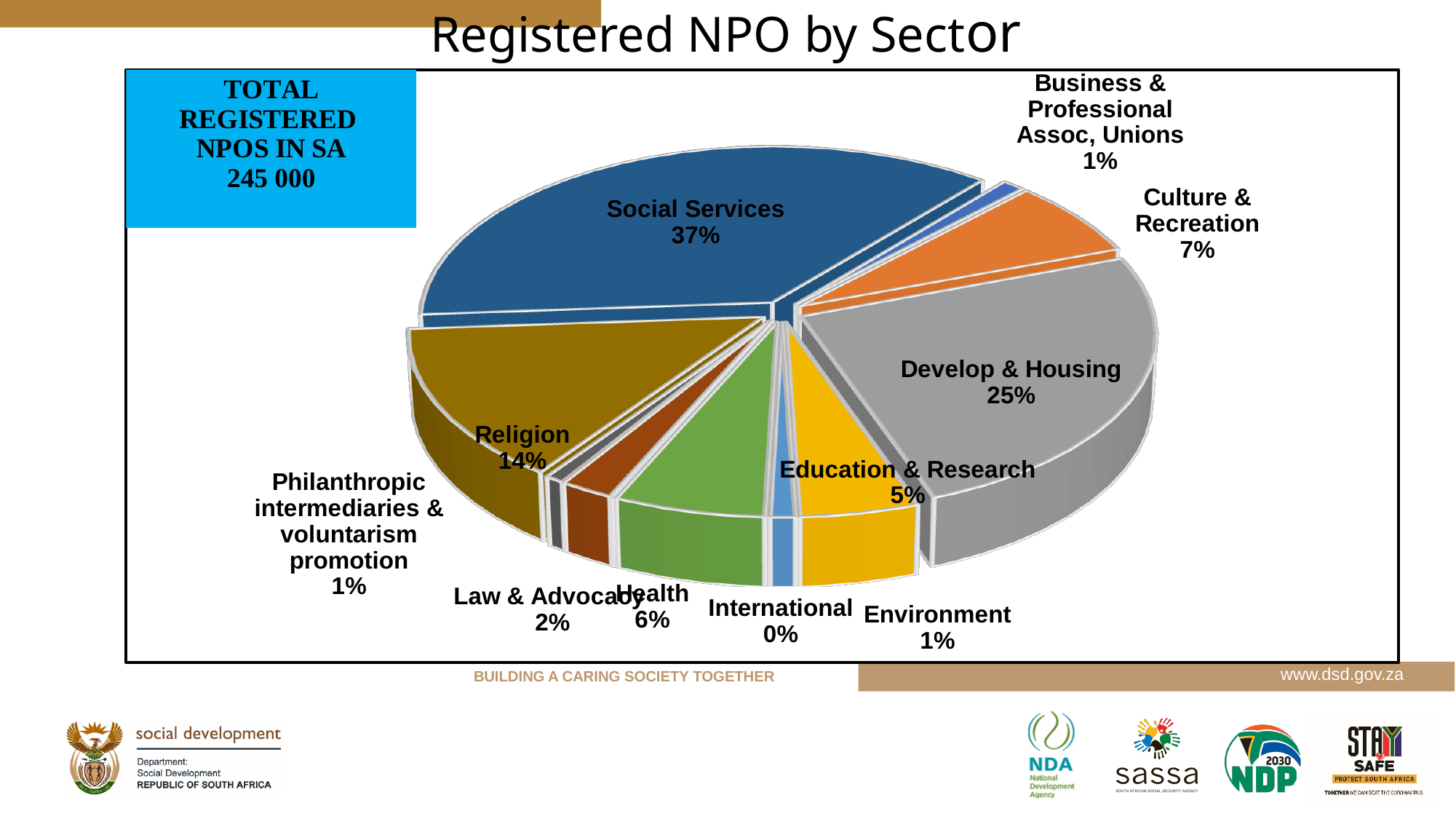
How many sectors are shown in the pie chart? 11 What is the total number of registered NPOs in SA stated on the slide? 245 000 What share of registered NPOs is in the Social Services sector? 37% Which sector has the largest share of registered NPOs? Social Services What percentage is shown for the International sector? 0% What kind of chart is shown on the slide? Pie chart What percentage of registered NPOs is in Develop & Housing? 25% What percentage is shown for Culture & Recreation? 7% What share does the Religion sector hold? 14% What is the difference in percentage points between Social Services and Develop & Housing? 12 Which sector has the smallest share of registered NPOs? International Which has a larger share, Health or Education & Research? Health